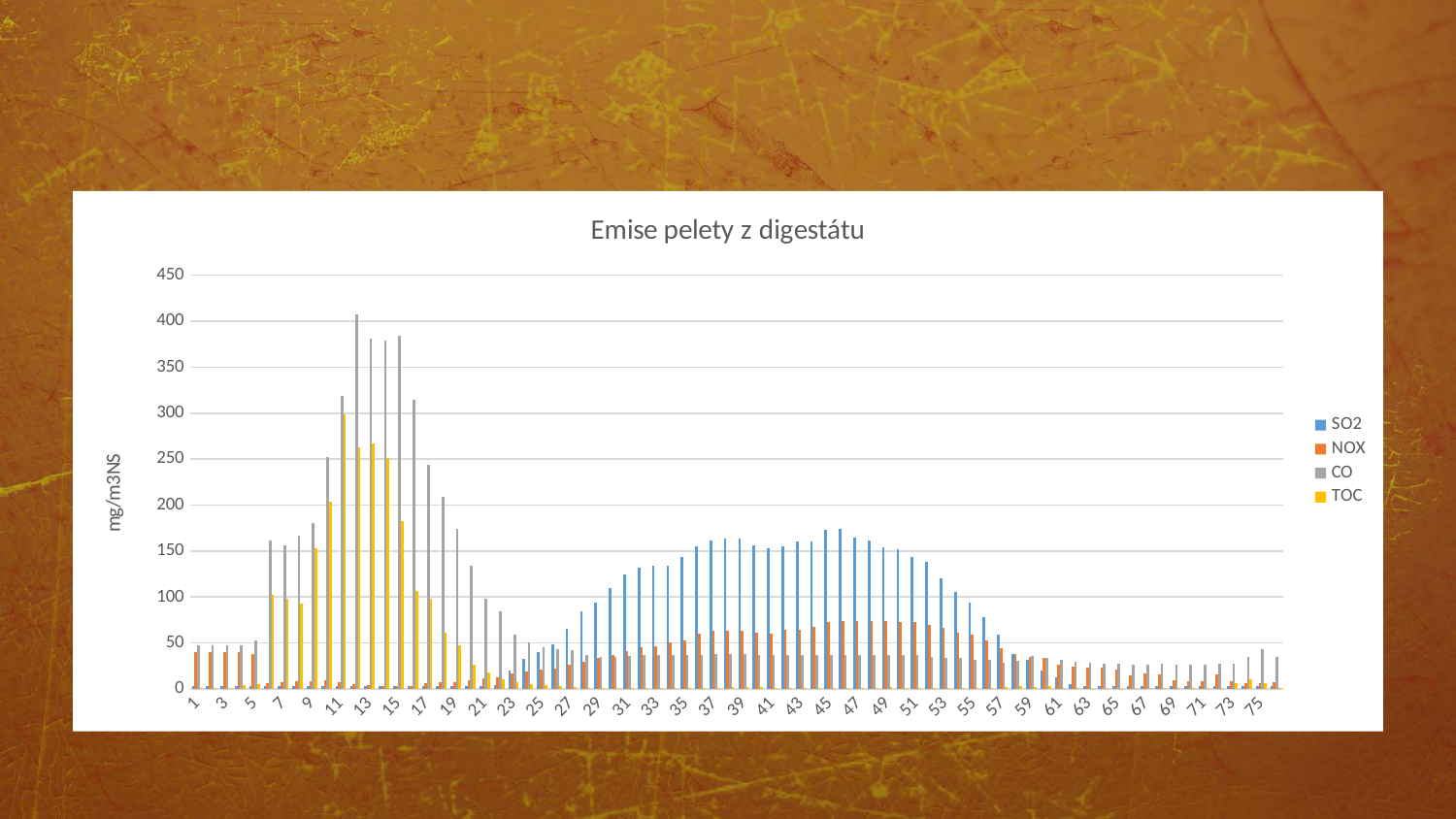
What is the title of the chart? Emise pelety z digestátu At category 37, which is larger, the SO2 value or the NOX value? SO2 Is the SO2 value at category 45 greater or less than 150? greater At category 13, which is larger, the CO value or the TOC value? CO Is the CO value at category 12 greater or less than 350? greater Which series reaches the highest value anywhere on the chart? CO Is the NOX value at category 1 greater or less than 50? less What is the label on the vertical axis? mg/m3NS What type of chart is shown on the slide? bar chart Do the SO2 values rise or fall from category 47 to category 59? fall How many series does the legend list? 4